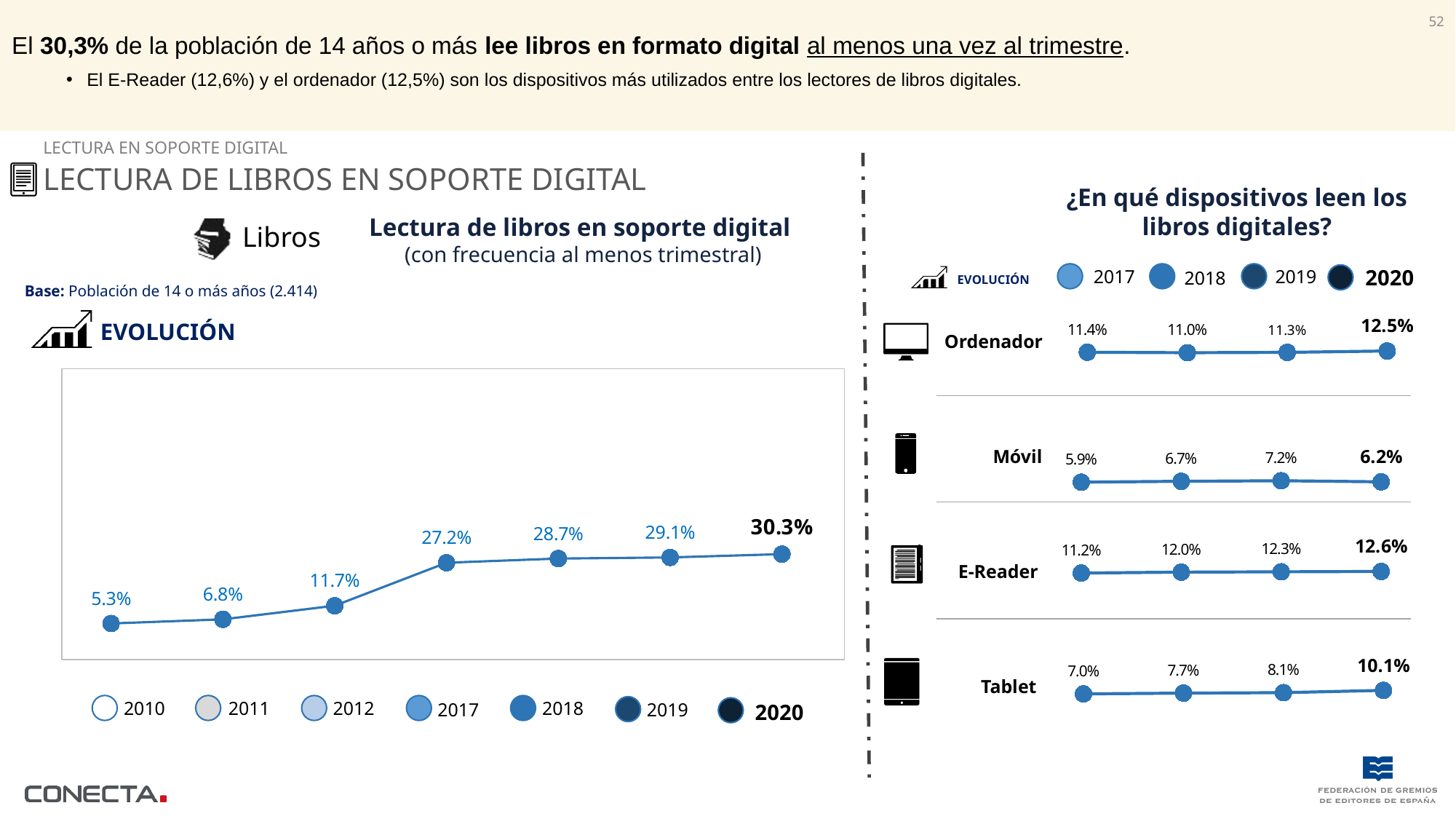
In the 'Lectura de libros en soporte digital' chart, do the values rise or fall from 2010 to 2020? rise In the 'Lectura de libros en soporte digital' chart, how many data points are plotted? 7 In the 'Lectura de libros en soporte digital' chart, what is the difference between the 2020 and 2010 values? 25.0 percentage points In the '¿En qué dispositivos leen los libros digitales?' chart, which device has the highest 2020 value? E-Reader In the 'Lectura de libros en soporte digital' chart, which year has the lowest value? 2010 In the '¿En qué dispositivos leen los libros digitales?' chart, is the 2019 value for Ordenador or for E-Reader larger? E-Reader What kind of chart is the 'Lectura de libros en soporte digital' chart? line chart In the '¿En qué dispositivos leen los libros digitales?' chart, what is the 2020 value for Tablet? 10.1% In the '¿En qué dispositivos leen los libros digitales?' chart, what is the 2018 value for Móvil? 6.7% In the 'Lectura de libros en soporte digital' chart, what is the value for 2012? 11.7% In the '¿En qué dispositivos leen los libros digitales?' chart, how many years does the legend list? 4 In the 'Lectura de libros en soporte digital' chart, what is the value for 2020? 30.3%